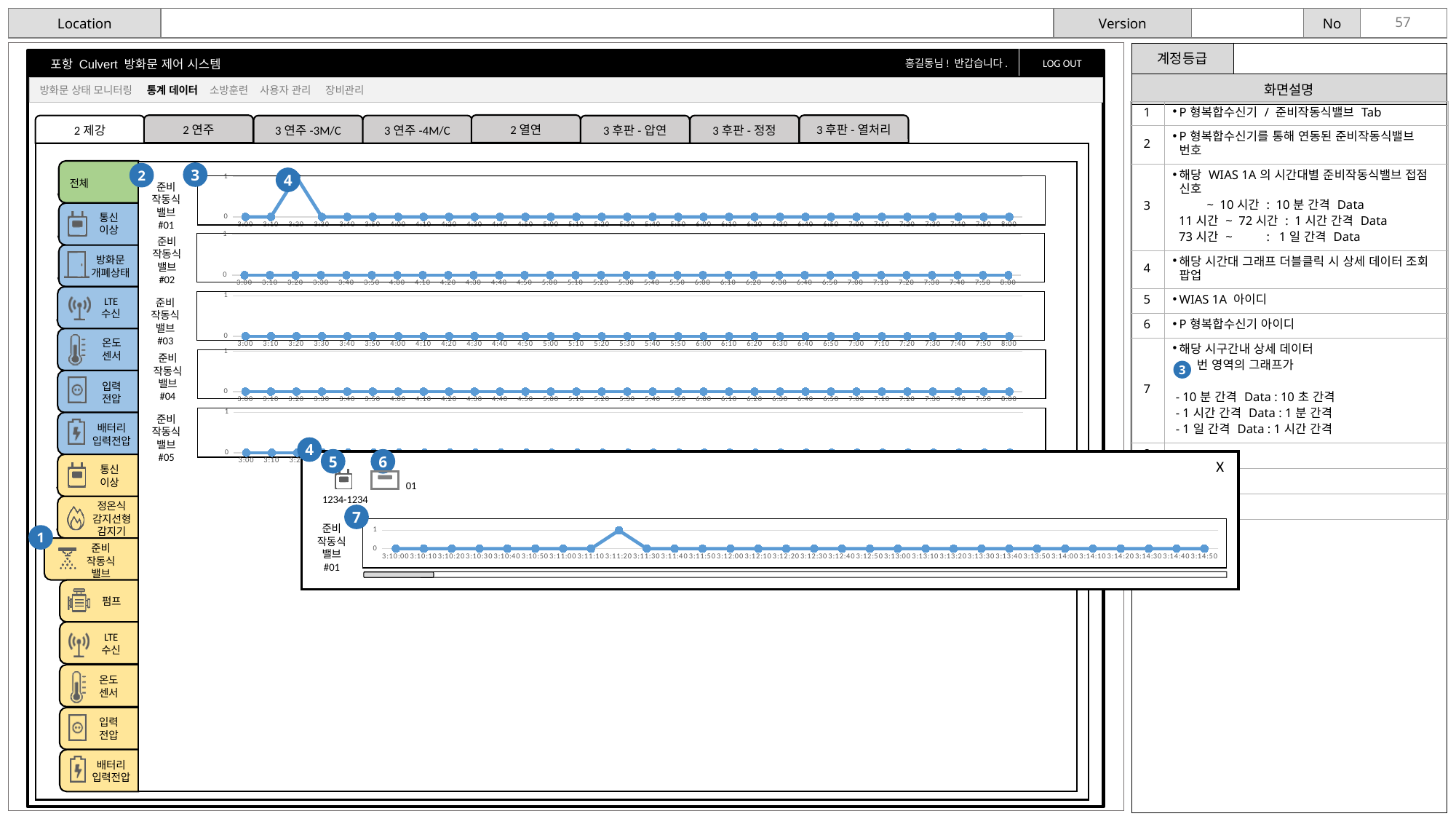
What is the first x-axis label of the 준비작동식밸브 #01 chart in the popup window? 3:10:00 In the 준비작동식밸브 #02 chart in the main panel, is the value at 4:00 greater or less than 1? less In the 준비작동식밸브 #01 chart in the main panel, which is larger, the value at 3:20 or the value at 3:30? 3:20 How many 준비작동식밸브 line charts are stacked in the main panel (excluding the popup)? 5 What kind of chart is used for 준비작동식밸브 #01 in the main panel? line chart In the 준비작동식밸브 #01 chart in the main panel, what is the value at 3:00? 0 In the 준비작동식밸브 #01 chart in the popup window, at which time is the value highest? 3:11:20 In the 준비작동식밸브 #01 chart in the main panel, what is the value at 3:20? 1 In the 준비작동식밸브 #01 chart in the popup window, what is the value at 3:10:00? 0 In the 준비작동식밸브 #01 chart in the main panel, what is the difference between the value at 3:20 and the value at 3:10? 1 In the 준비작동식밸브 #01 chart in the popup window, what is the value at 3:11:20? 1 In the 준비작동식밸브 #01 chart in the main panel, at which time is the value highest? 3:20